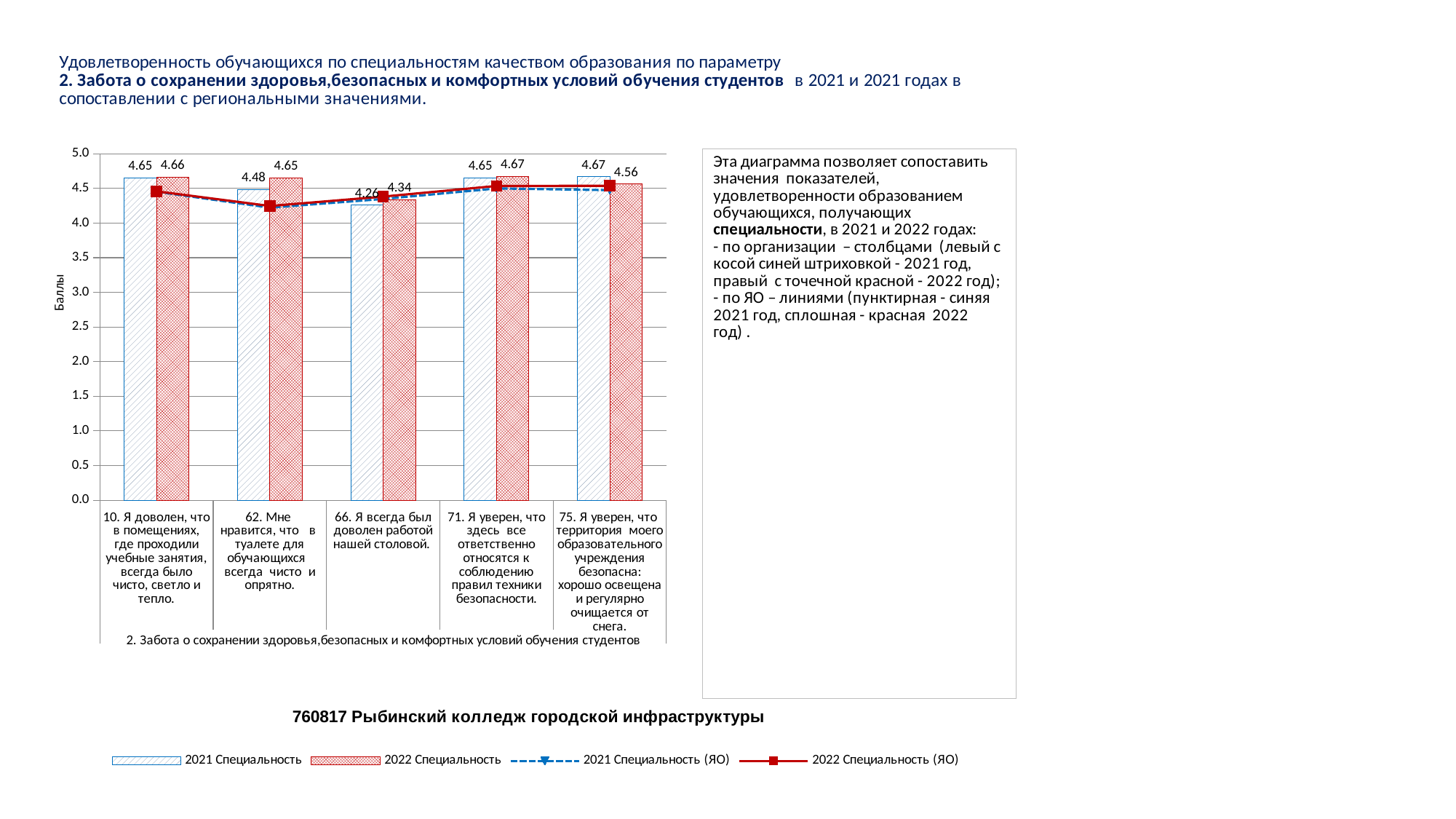
What is the 2022 Специальность value for category 75 (Я уверен, что территория моего образовательного учреждения безопасна)? 4.56 What is the label of the y axis? Баллы What is the 2021 Специальность value for category 62 (Мне нравится, что в туалете для обучающихся всегда чисто и опрятно)? 4.48 How many categories are shown on the x axis? 5 Which category has the lowest 2021 Специальность value? 66. Я всегда был доволен работой нашей столовой. Which category has the highest 2021 Специальность value? 75. Я уверен, что территория моего образовательного учреждения безопасна What kind of chart is this? Combined bar and line chart How many series does the legend list? 4 What is the difference between the 2022 and 2021 Специальность values for category 62? 0.17 For category 75, which is larger: the 2021 Специальность value or the 2022 Специальность value? 2021 Специальность What is the 2022 Специальность value for category 66 (Я всегда был доволен работой нашей столовой)? 4.34 Is the 2021 Специальность (ЯО) line value for category 62 greater or less than 4.5? less